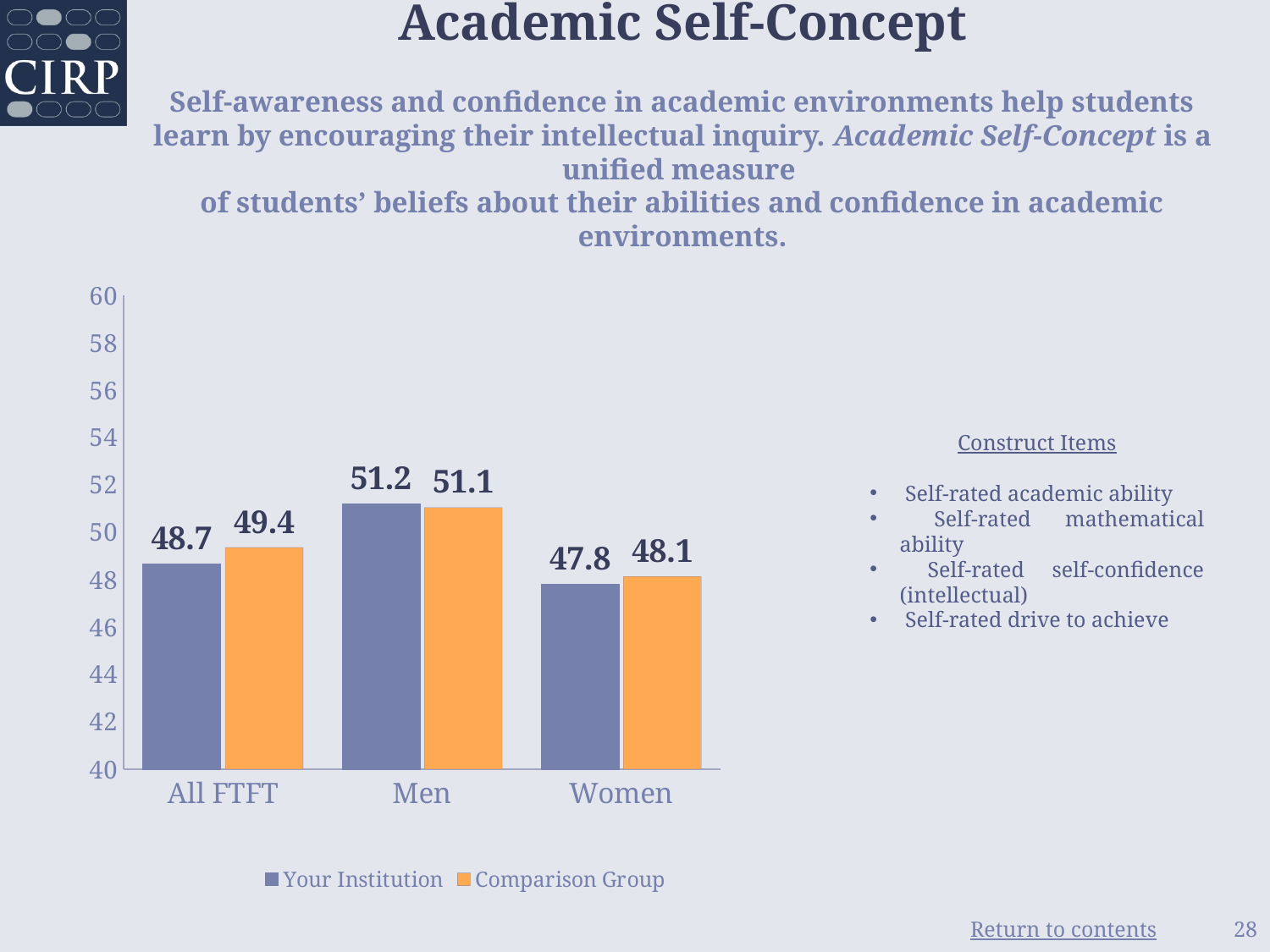
Which category has the highest value for Comparison Group? Men For Women, which is larger: Your Institution or Comparison Group? Comparison Group What is the value for Your Institution in the Men category? 51.2 What kind of chart is shown on the slide? bar chart Which category has the lowest value for Your Institution? Women What is the value for Comparison Group in the All FTFT category? 49.4 What is the difference between the Comparison Group and Your Institution values for All FTFT? 0.7 How many series does the legend list? 2 How many categories are shown on the x axis? 3 What colour are the Comparison Group bars? orange What is the difference between the Men and Women values for Your Institution? 3.4 What is the value for Your Institution in the Women category? 47.8